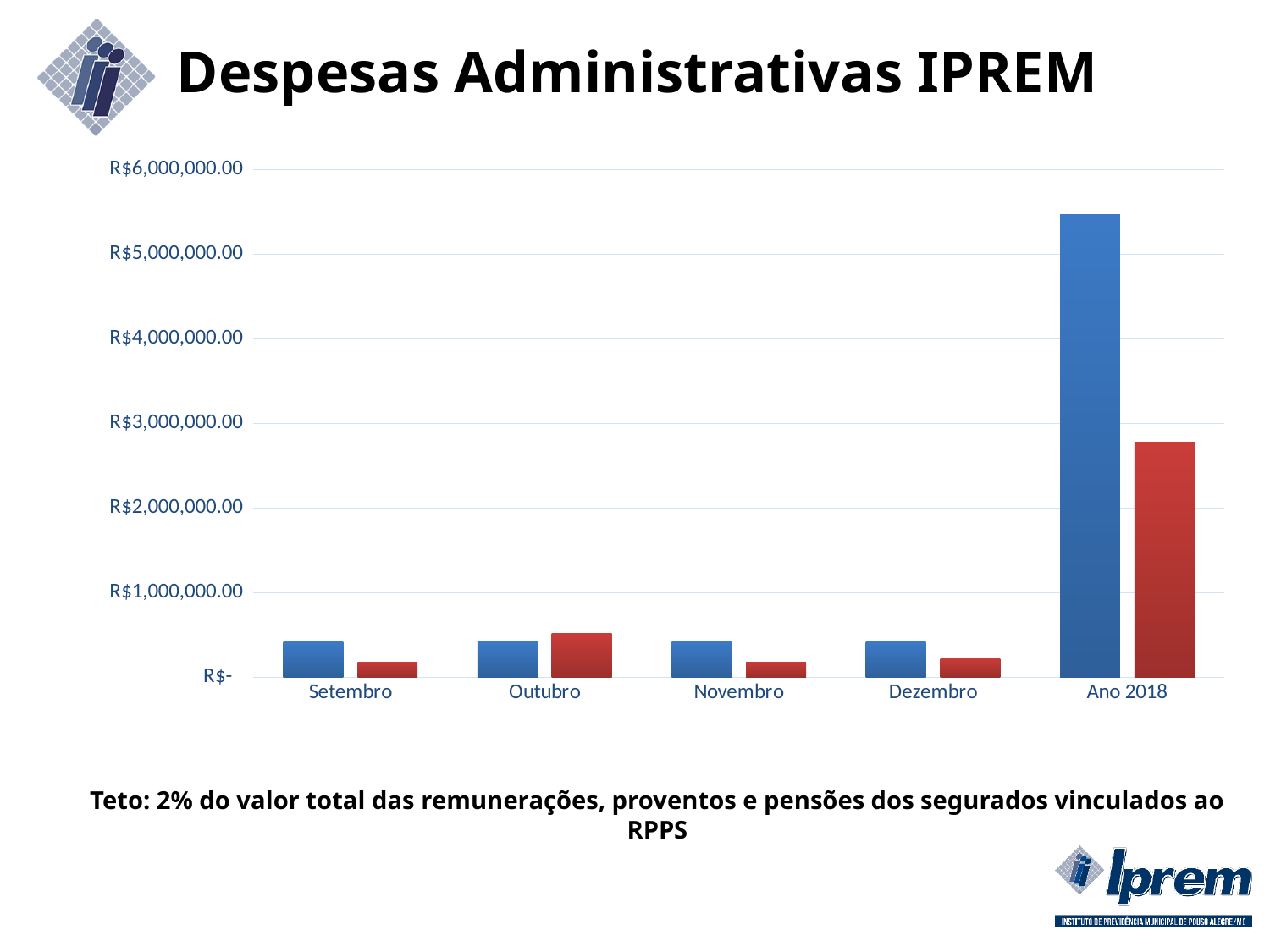
Which category has the tallest red bar? Ano 2018 Is the red bar for Ano 2018 greater or less than R$3,000,000.00? less How many bars are shown for each category on the chart? 2 Is the blue bar for Ano 2018 greater or less than R$5,000,000.00? greater What kind of chart is shown on the slide? bar chart Which category has the tallest blue bar? Ano 2018 Among the monthly categories (Setembro to Dezembro), which has the tallest red bar? Outubro For Outubro, which bar is taller, the blue one or the red one? the red one For Setembro, which bar is taller, the blue one or the red one? the blue one Is the red bar for Outubro greater or less than R$1,000,000.00? less What is the title of the chart on the slide? Despesas Administrativas IPREM How many categories are shown on the x axis of the chart? 5